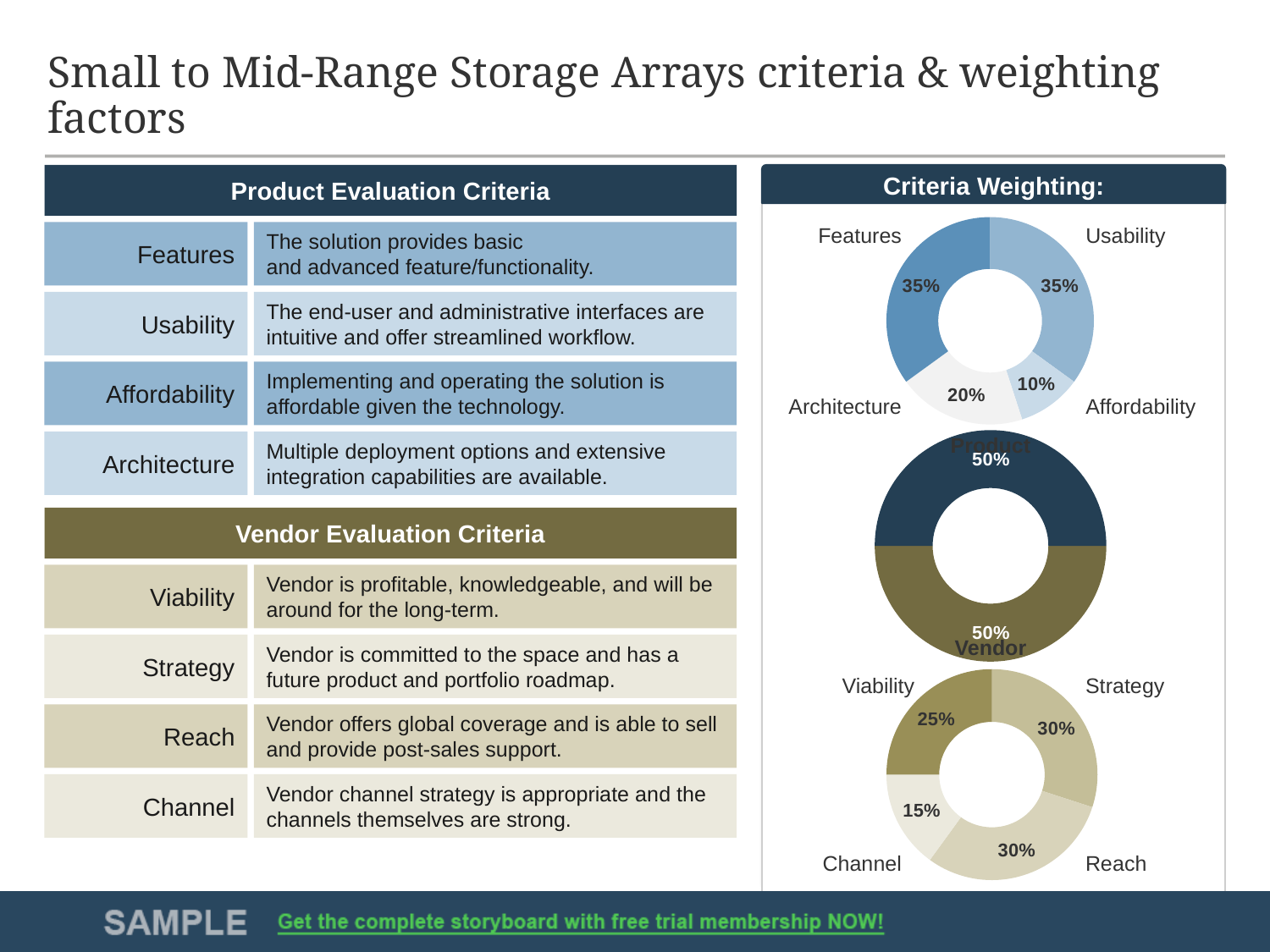
In the top donut chart under Criteria Weighting, how many categories are shown? 4 In the bottom donut chart under Criteria Weighting, what is the difference between Strategy and Channel? 15% In the middle donut chart under Criteria Weighting, what is the value for Vendor? 50% What type of chart is used for the Criteria Weighting visuals? Donut chart In the top donut chart under Criteria Weighting, what is the value for Affordability? 10% In the top donut chart under Criteria Weighting, what is the difference between Features and Architecture? 15% In the bottom donut chart under Criteria Weighting, what is the value for Channel? 15% In the bottom donut chart under Criteria Weighting, which is larger, Viability or Strategy? Strategy In the top donut chart under Criteria Weighting, what is the value for Architecture? 20% In the middle donut chart under Criteria Weighting, how many slices are there? 2 In the bottom donut chart under Criteria Weighting, what is the value for Viability? 25% In the top donut chart under Criteria Weighting, which category has the lowest value? Affordability